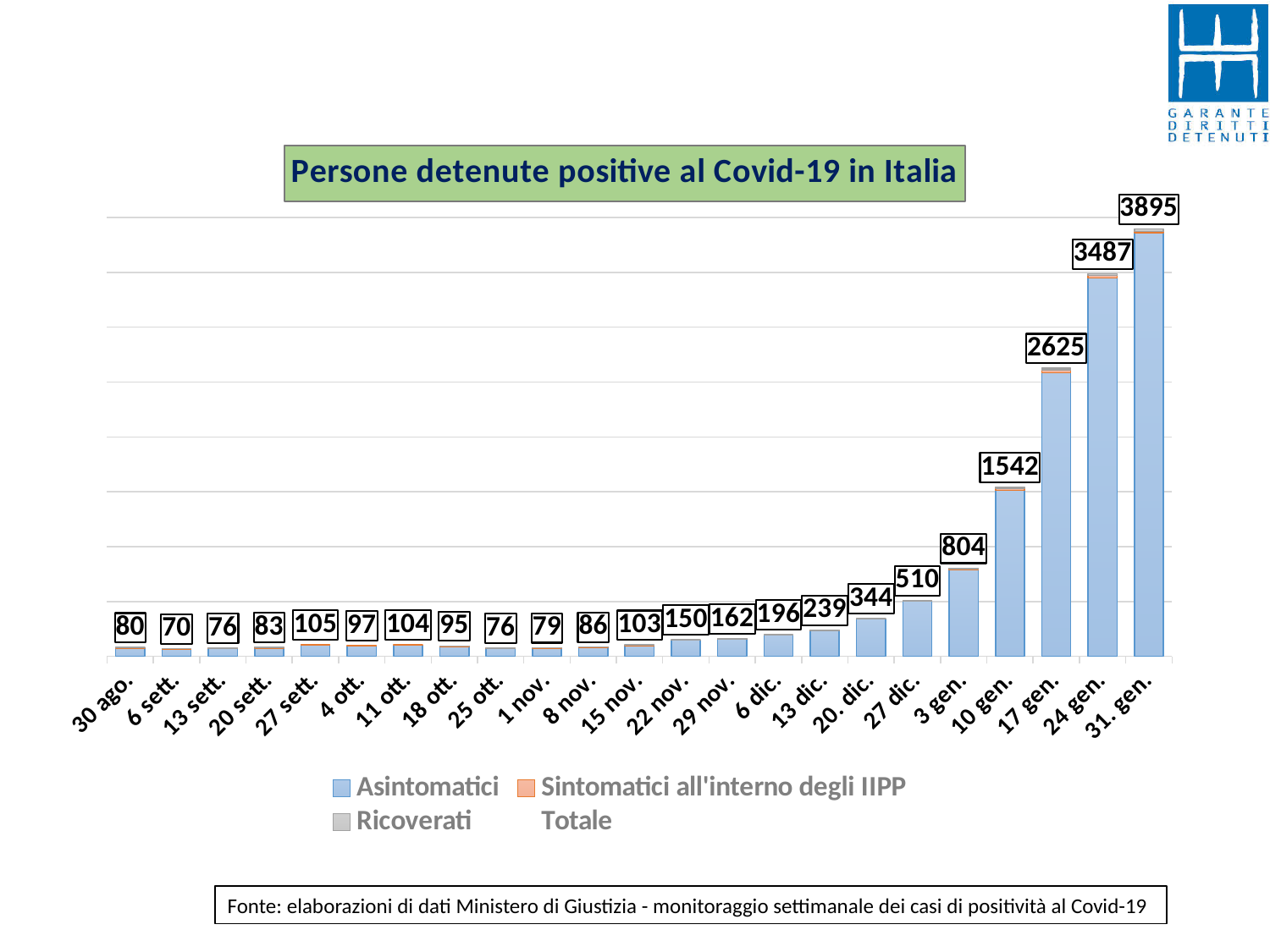
What is the total value shown for 31. gen.? 3895 What is the total value shown for 27 sett.? 105 Which date has the lowest total? 6 sett. What is the total value shown for 3 gen.? 804 How many dates are shown on the x axis? 23 What is the difference between the totals for 10 gen. and 3 gen.? 738 What is the title of the chart? Persone detenute positive al Covid-19 in Italia Which is larger, the total for 22 nov. or the total for 29 nov.? 29 nov. What kind of chart is shown? bar chart How many entries does the legend list? 4 What is the difference between the totals for 31. gen. and 24 gen.? 408 Which date has the highest total? 31. gen.